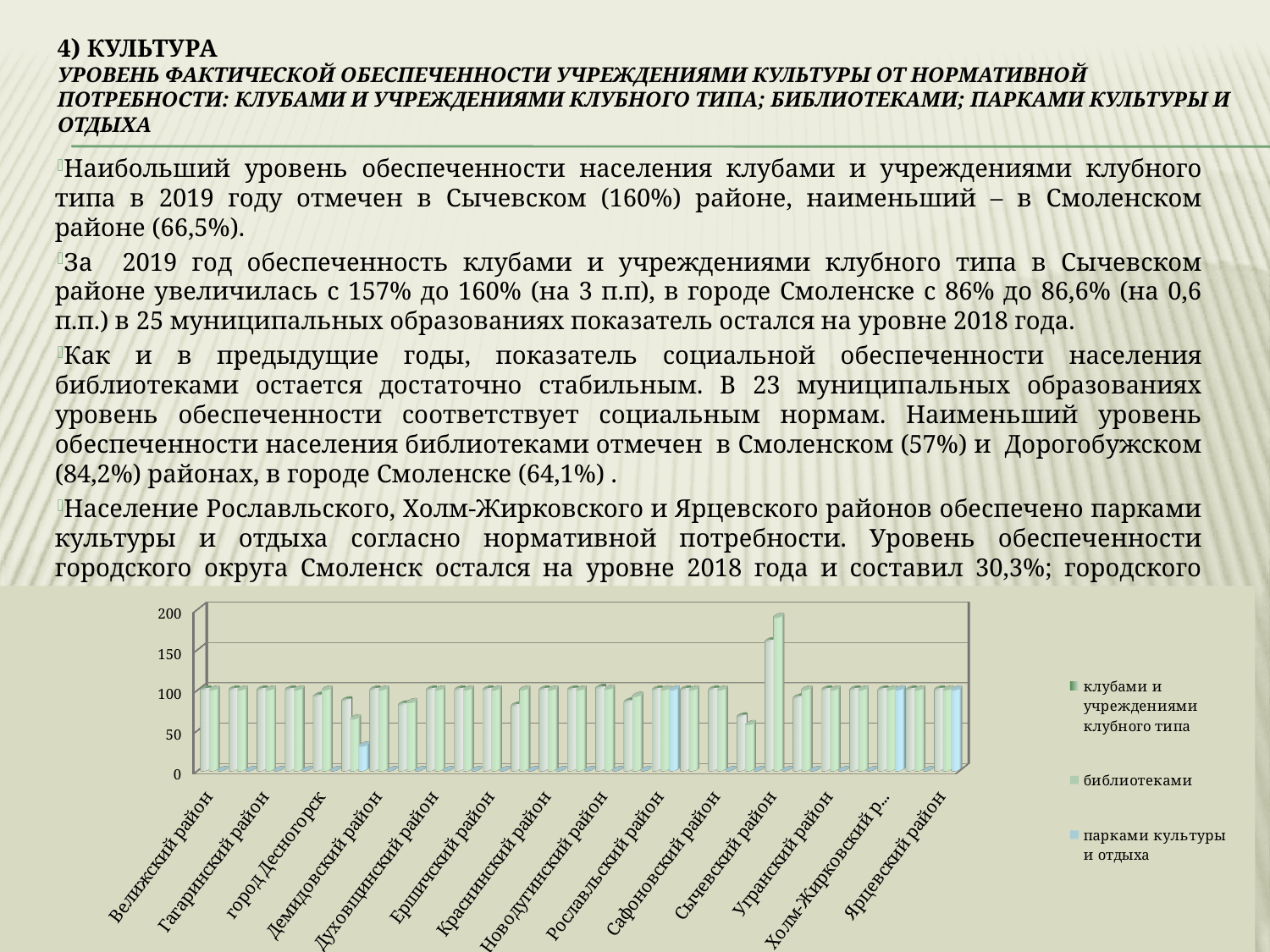
Is the value for парками культуры и отдыха in Гагаринский район greater or less than 50? less Which is larger: the клубами и учреждениями клубного типа value for Сычевский район or for Велижский район? Сычевский район Is the value for клубами и учреждениями клубного типа in Сычевский район greater or less than 150? greater Is the value for библиотеками in Сычевский район greater or less than 150? greater What is the highest tick value shown on the chart's vertical axis? 200 Which category has the highest value for библиотеками? Сычевский район What are the three series named in the chart legend? клубами и учреждениями клубного типа; библиотеками; парками культуры и отдыха What kind of chart is shown on the slide? bar chart For Сычевский район, which series has the larger value: библиотеками or клубами и учреждениями клубного типа? библиотеками How many series does the chart legend list? 3